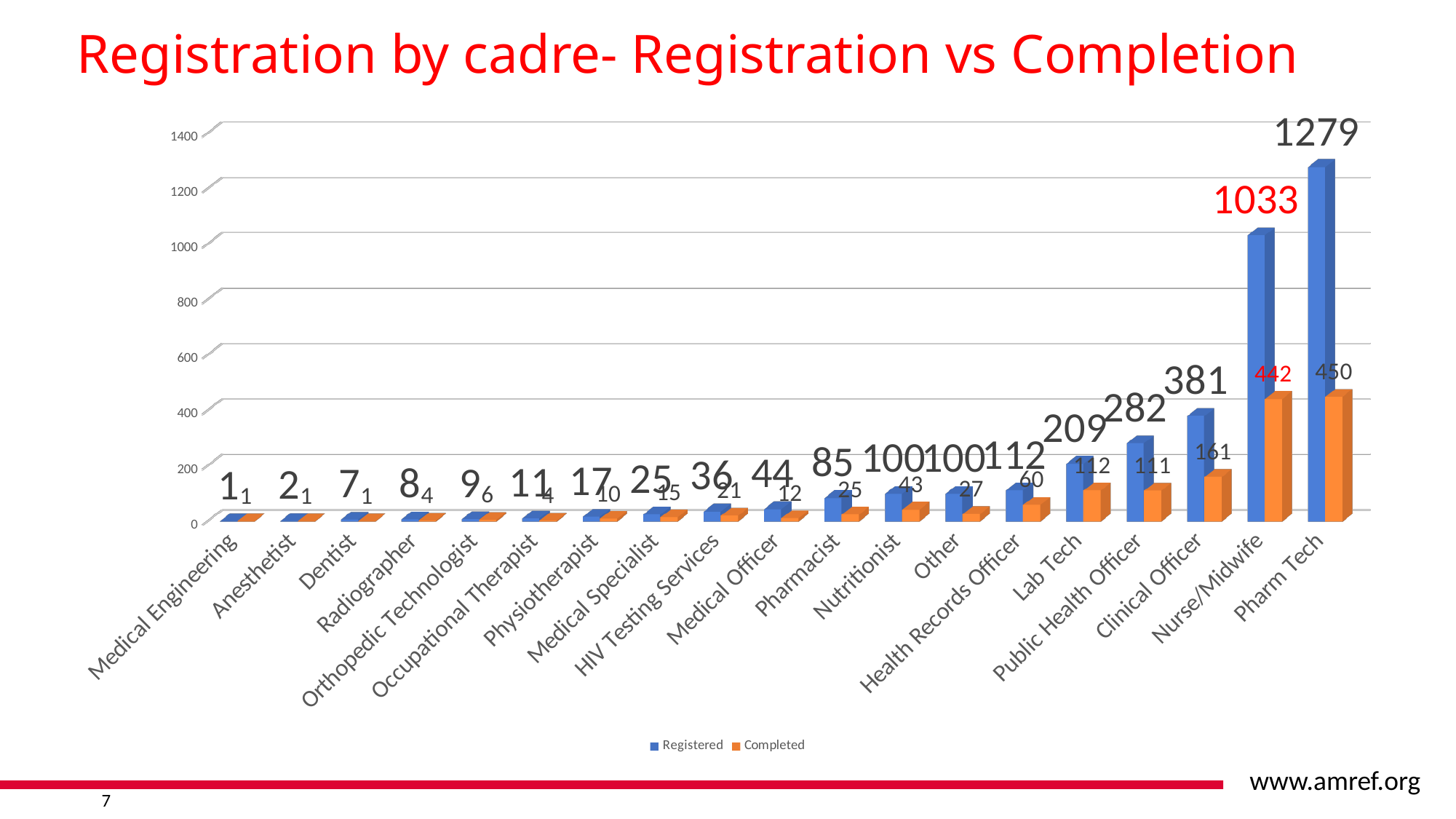
Is the Registered value for Nurse/Midwife greater or less than 1000? greater Which is larger, the Completed value for Public Health Officer or the Completed value for Clinical Officer? Clinical Officer What kind of chart is shown on the slide? Bar chart How many series does the legend list? 2 Which cadre has the lowest Registered value? Medical Engineering How many cadres are shown on the x axis? 19 What is the Completed value for Nurse/Midwife? 442 What is the Registered value for Clinical Officer? 381 What is the Completed value for Lab Tech? 112 What is the difference between the Registered and Completed values for Nurse/Midwife? 591 Which cadre has the highest Registered value? Pharm Tech What is the Registered value for Pharm Tech? 1279